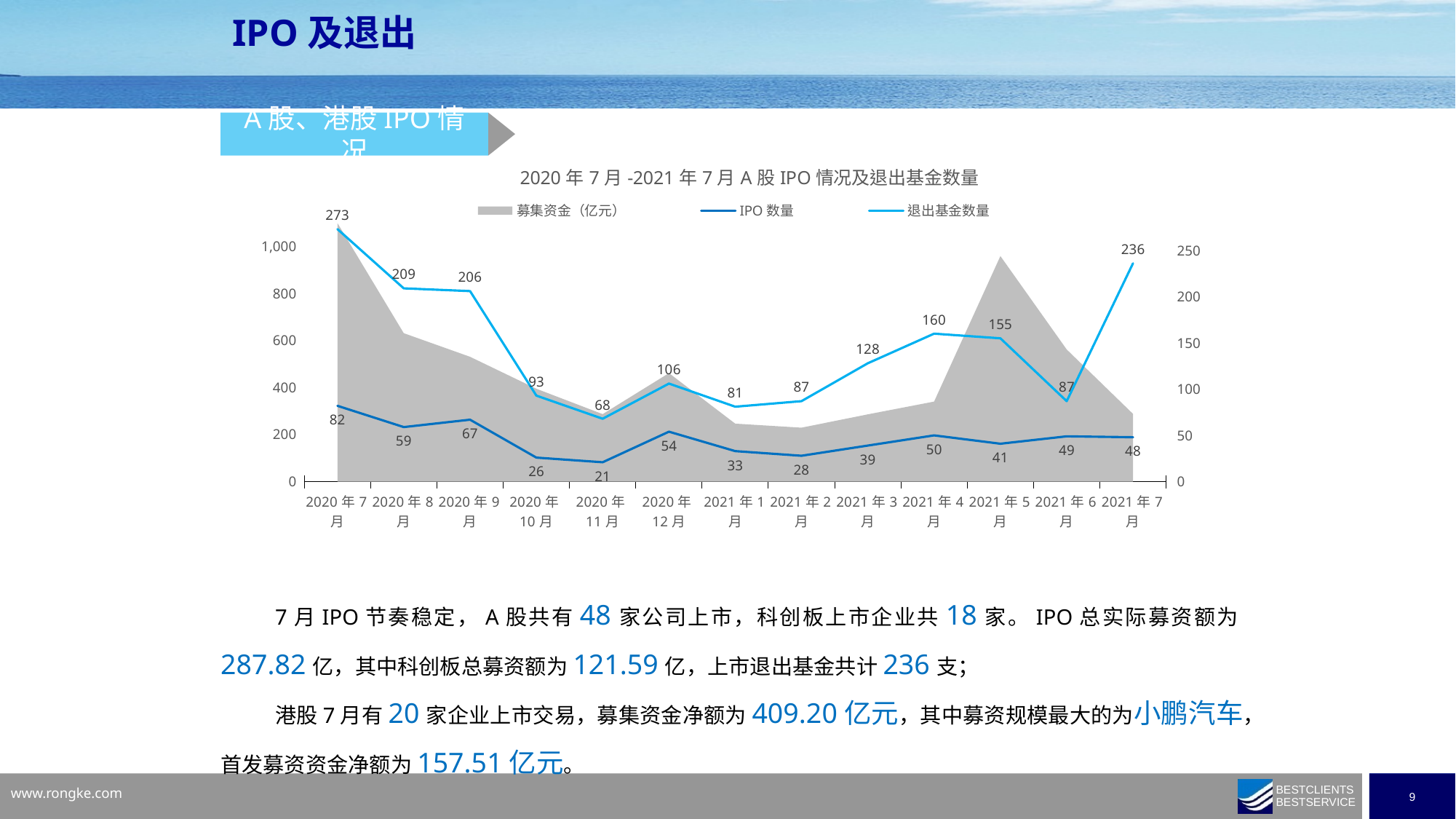
What is the IPO 数量 value for 2020 年 7 月? 82 Is the 募集资金（亿元） value for 2020 年 11 月 greater or less than 400? less How many months are shown on the x axis of the chart? 13 How many series does the chart legend list? 3 Does the 退出基金数量 series rise or fall from 2020 年 7 月 to 2020 年 11 月? fall Which month has the lowest IPO 数量? 2020 年 11 月 Which month has the highest 退出基金数量? 2020 年 7 月 What is the difference between the 退出基金数量 values for 2021 年 7 月 and 2021 年 6 月? 149 Is the 募集资金（亿元） value for 2021 年 5 月 greater or less than 800? greater What is the 退出基金数量 value for 2021 年 7 月? 236 Which is larger, the IPO 数量 for 2020 年 8 月 or for 2020 年 9 月? 2020 年 9 月 What is the 退出基金数量 value for 2020 年 11 月? 68